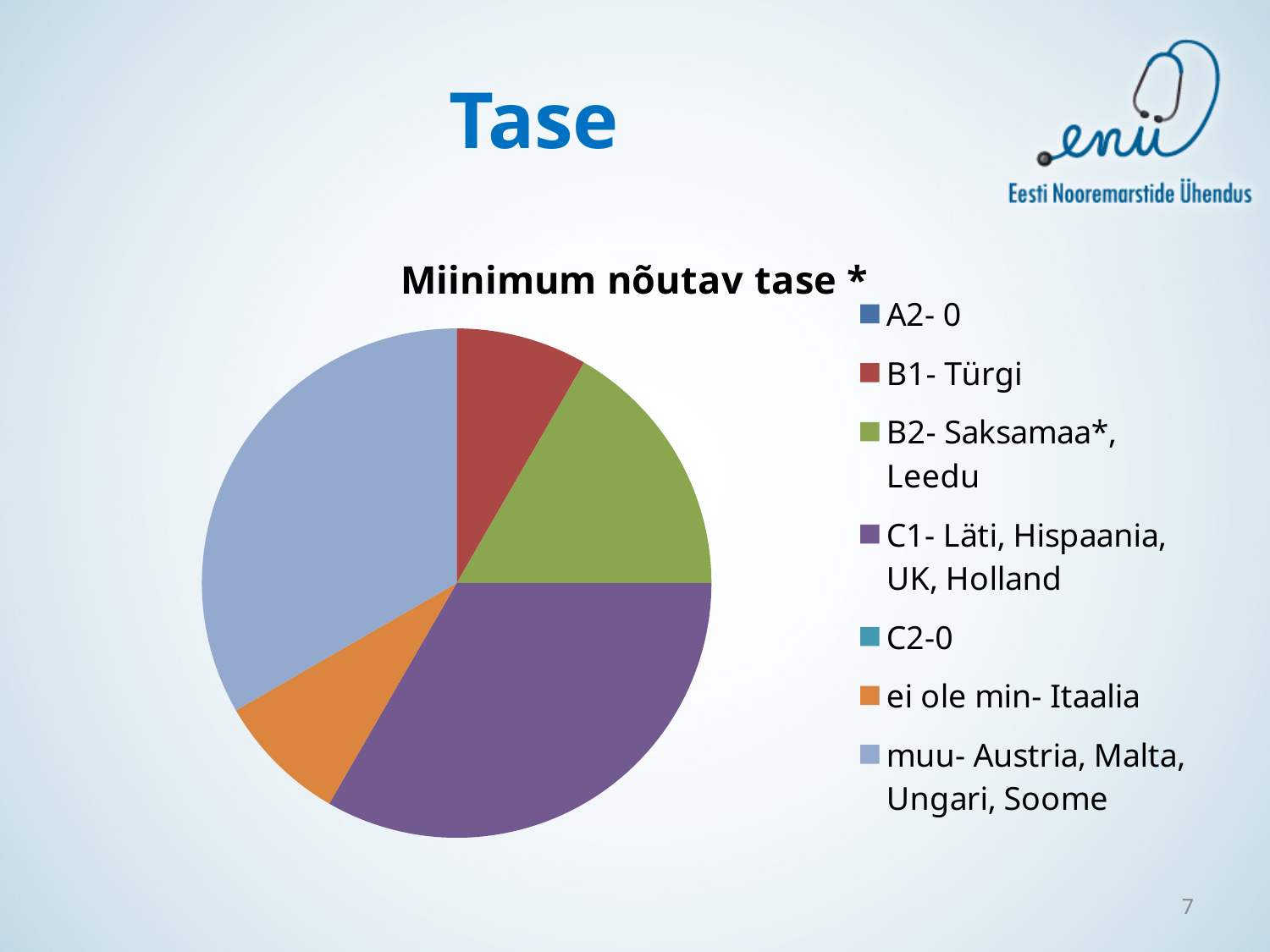
Which countries are listed under the C1 level in the legend? Läti, Hispaania, UK, Holland How many entries does the chart legend list? 7 How many countries are listed under the A2 level? 0 Which slice is larger, muu or B1? muu Which slice is larger, C1 or B1? C1 What kind of chart is shown on the slide? pie chart Which country is listed under the B1 level in the legend? Türgi Which countries are listed under the 'muu' category? Austria, Malta, Ungari, Soome What is the title of the chart? Miinimum nõutav tase * Which country is listed as having no minimum level (ei ole min)? Itaalia What colour is the slice for C1 in the pie chart? purple Which slice is larger, B2 or ei ole min? B2